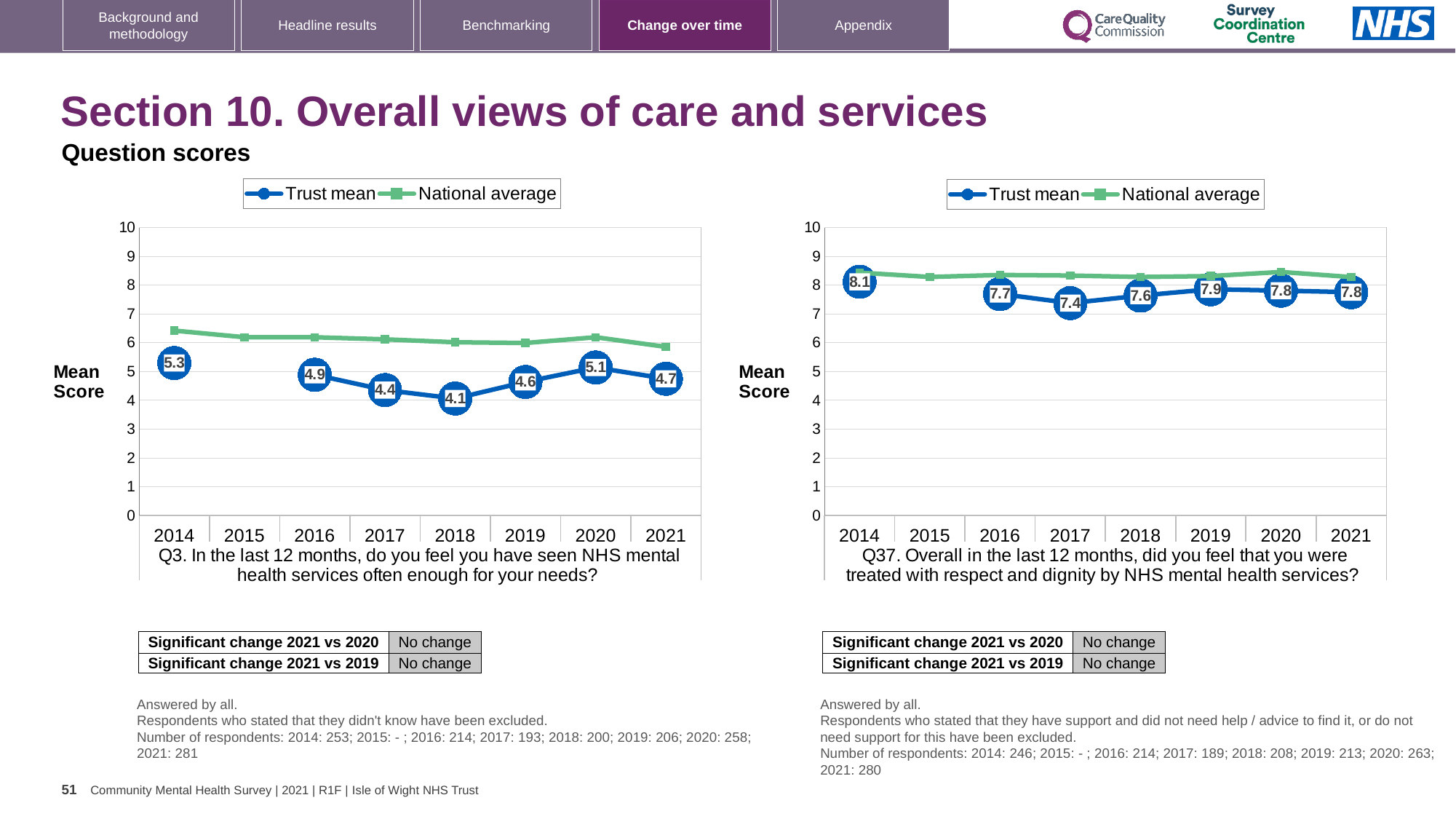
In the right chart (Q37), what is the Trust mean score for 2017? 7.4 In the left chart (Q3), what is the Trust mean score for 2020? 5.1 In the left chart (Q3), is the National average value for 2014 greater or less than 6? greater What type of chart is the right chart (Q37)? Line chart In the right chart (Q37), what is the Trust mean score for 2021? 7.8 In the left chart (Q3), what is the difference between the Trust mean scores for 2014 and 2021? 0.6 In the right chart (Q37), which year has the highest Trust mean score? 2014 How many series does the legend of the left chart (Q3) list? 2 In the left chart (Q3), which year has the lowest Trust mean score? 2018 How many years are shown on the x axis of the right chart (Q37)? 8 In the right chart (Q37), which is larger, the Trust mean score for 2016 or for 2019? 2019 In the left chart (Q3), what is the Trust mean score for 2018? 4.1